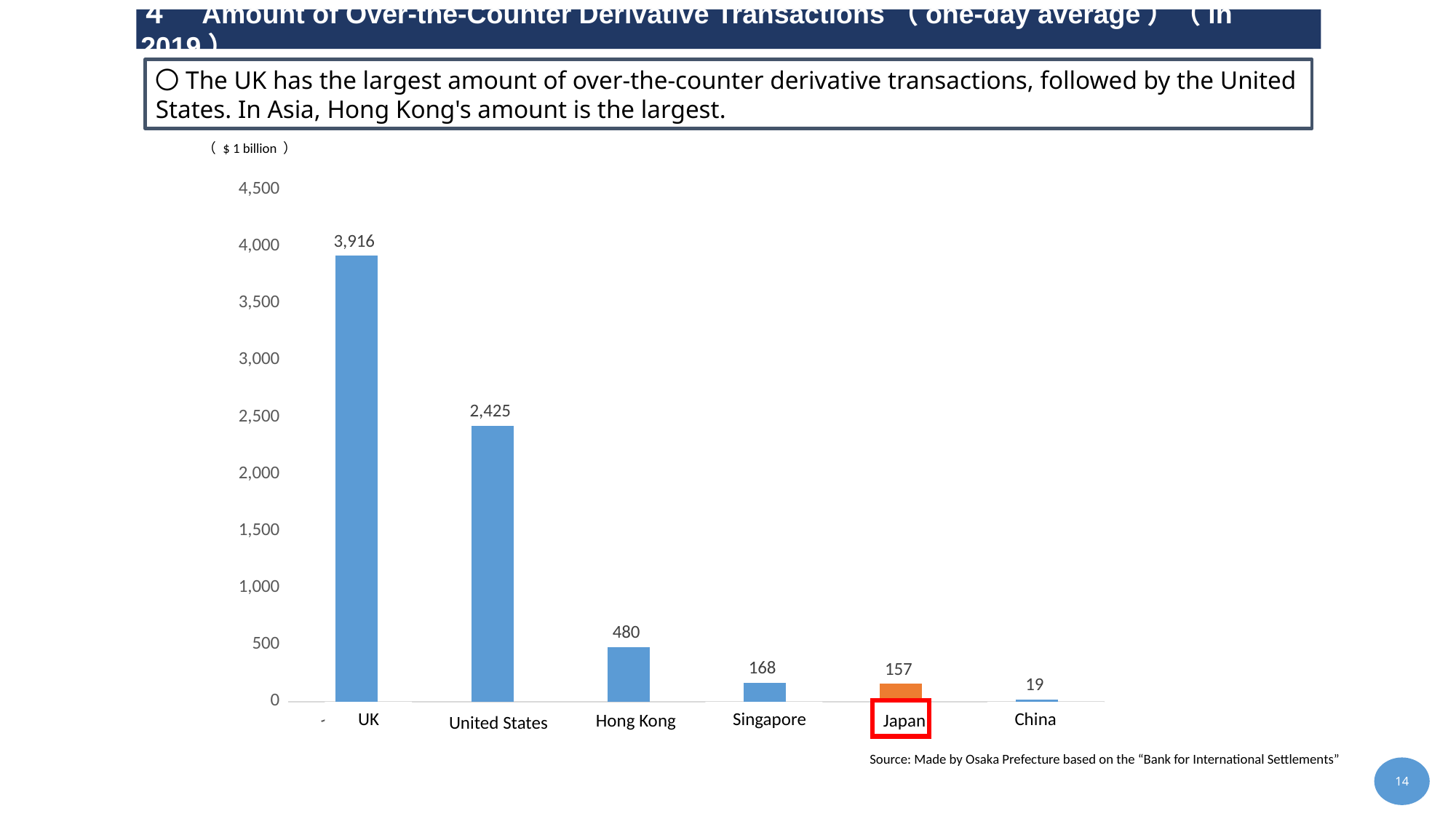
What is the value for China? 19 What is the value for Japan? 157 Which category has the highest value? UK How many categories are shown in the chart? 6 What kind of chart is shown on the slide? Bar chart What is the value for Hong Kong? 480 Which bar is coloured orange instead of blue? Japan Which category has the lowest value? China What is the difference between the values for the UK and the United States? 1,491 Which is larger, the value for Hong Kong or the value for Singapore? Hong Kong What is the value for the UK? 3,916 What is the difference between the values for Singapore and Japan? 11